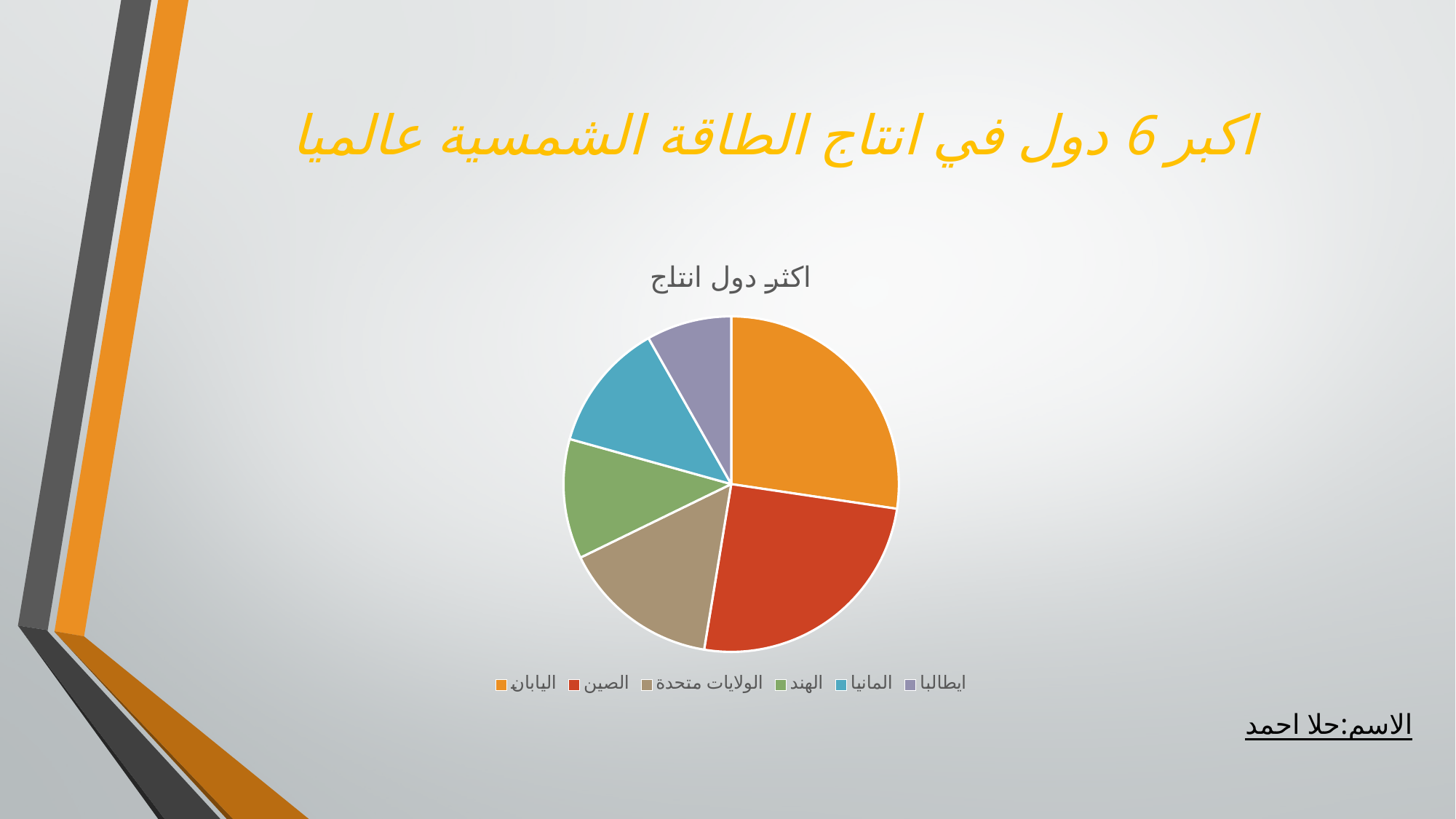
Which slice is larger, المانيا or ايطاليا? المانيا What colour is the slice for الصين in the pie chart? red Which slice is larger, اليابان or الهند? اليابان Which country has the smallest slice in the pie chart? ايطالبا How many entries does the legend of the pie chart list? 6 What kind of chart is shown on the slide? pie chart Which slice is larger, الصين or ايطاليا? الصين How many slices does the pie chart have? 6 Which country has the largest slice in the pie chart? اليابان What is the title of the pie chart? اكثر دول انتاج